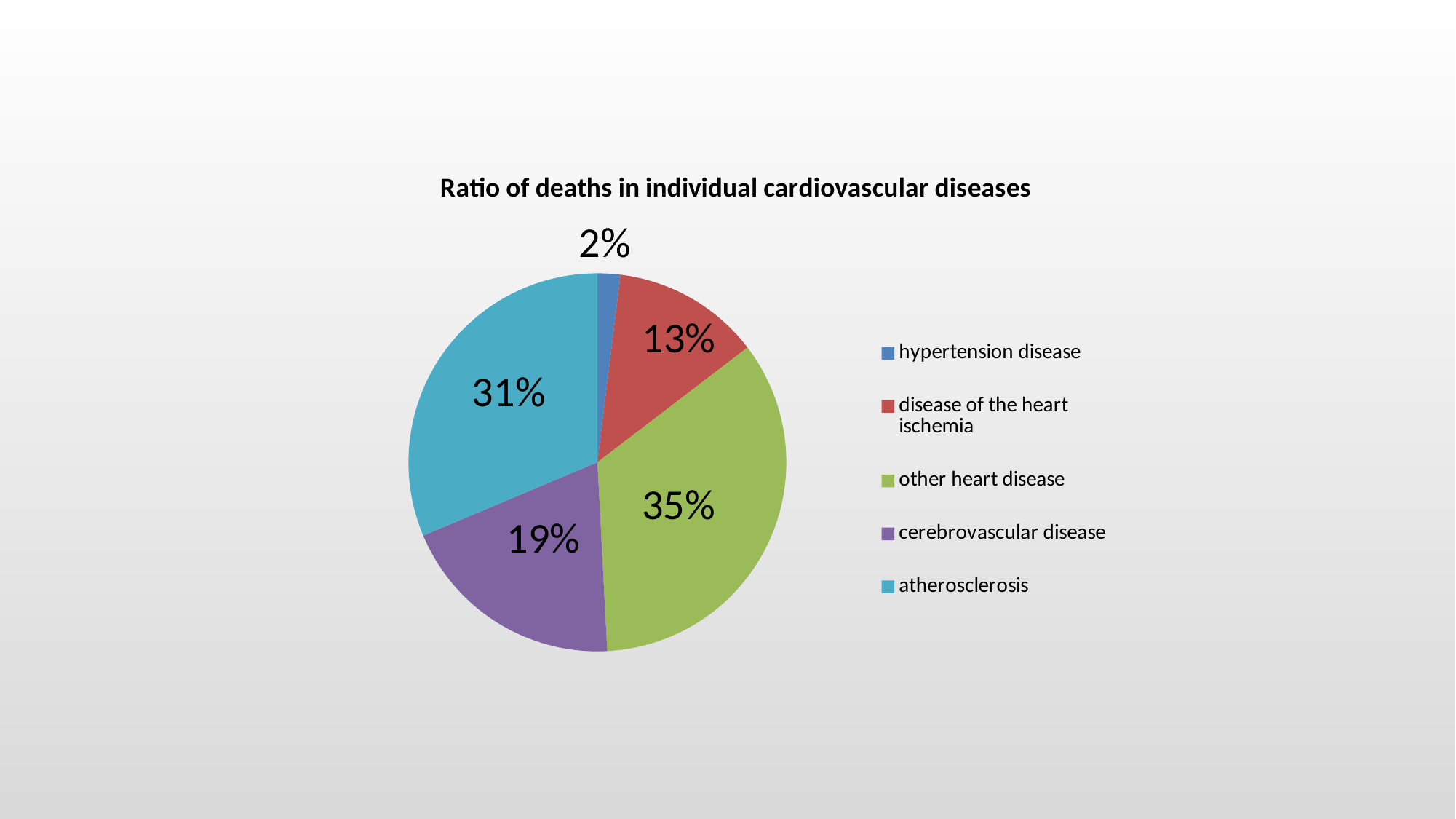
Which disease category has the smallest share of deaths? hypertension disease What share of deaths is attributed to cerebrovascular disease? 19% What is the title of the chart? Ratio of deaths in individual cardiovascular diseases How many disease categories does the pie chart show? 5 Which has a larger share of deaths, cerebrovascular disease or disease of the heart ischemia? cerebrovascular disease What kind of chart is shown on the slide? pie chart What share of deaths is attributed to disease of the heart ischemia? 13% What share of deaths is attributed to hypertension disease? 2% Which disease category has the largest share of deaths? other heart disease What is the difference in percentage points between the shares for other heart disease and atherosclerosis? 4